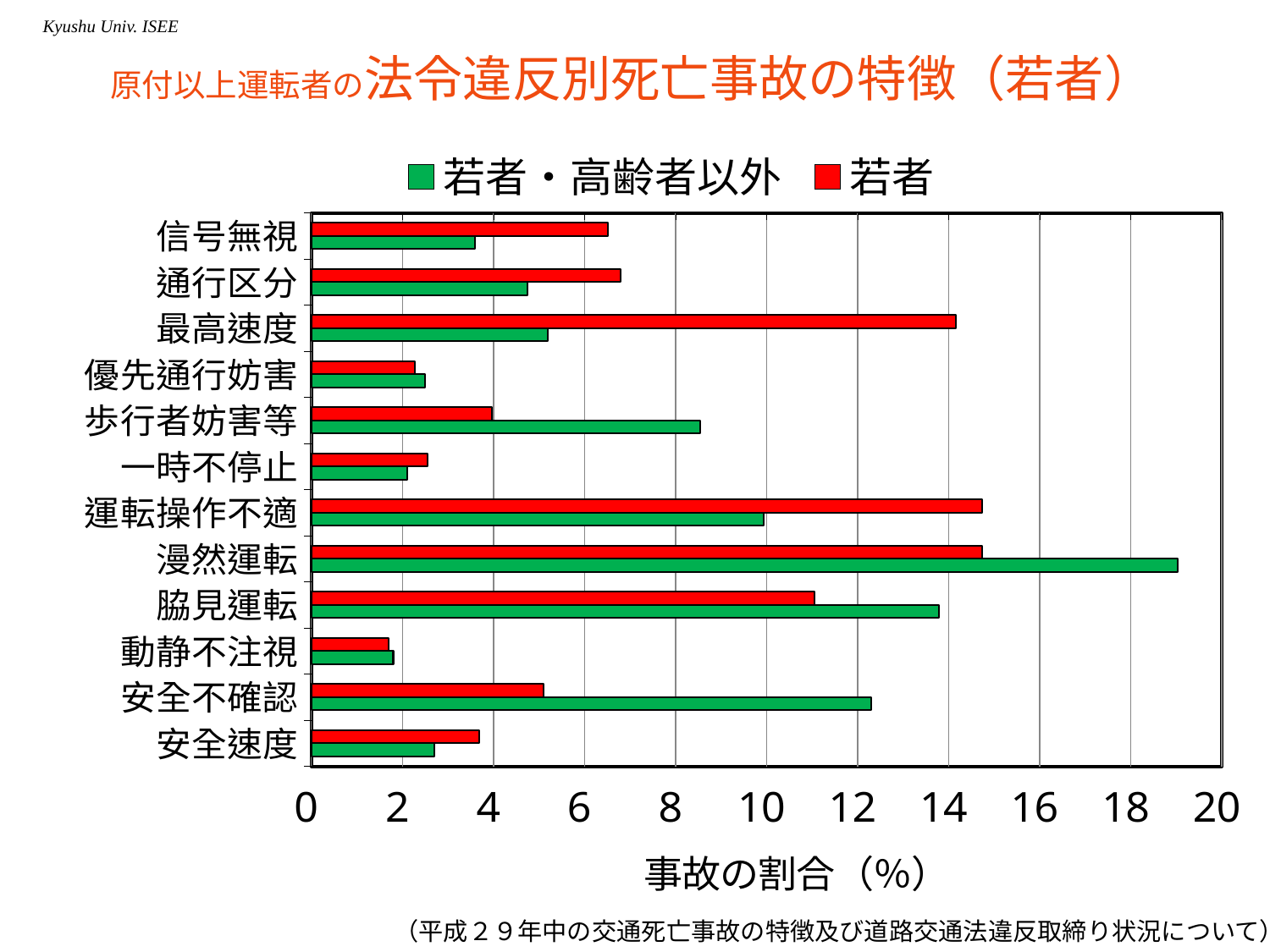
How many violation categories are plotted on the chart? 12 How many series does the legend list? 2 What kind of chart is shown on the slide? bar chart Is the value for 若者 in 最高速度 greater or less than 12? greater What is the title of the horizontal axis? 事故の割合（%） Is the value for 若者 in 脇見運転 greater or less than 10? greater For 最高速度, which series has the larger value, 若者 or 若者・高齢者以外? 若者 Which category has the lowest value for 若者? 動静不注視 Is the value for 若者・高齢者以外 in 漫然運転 greater or less than 18? greater Which category has the highest value for 若者・高齢者以外? 漫然運転 For 歩行者妨害等, which series has the larger value, 若者 or 若者・高齢者以外? 若者・高齢者以外 For 安全不確認, which series has the larger value, 若者 or 若者・高齢者以外? 若者・高齢者以外